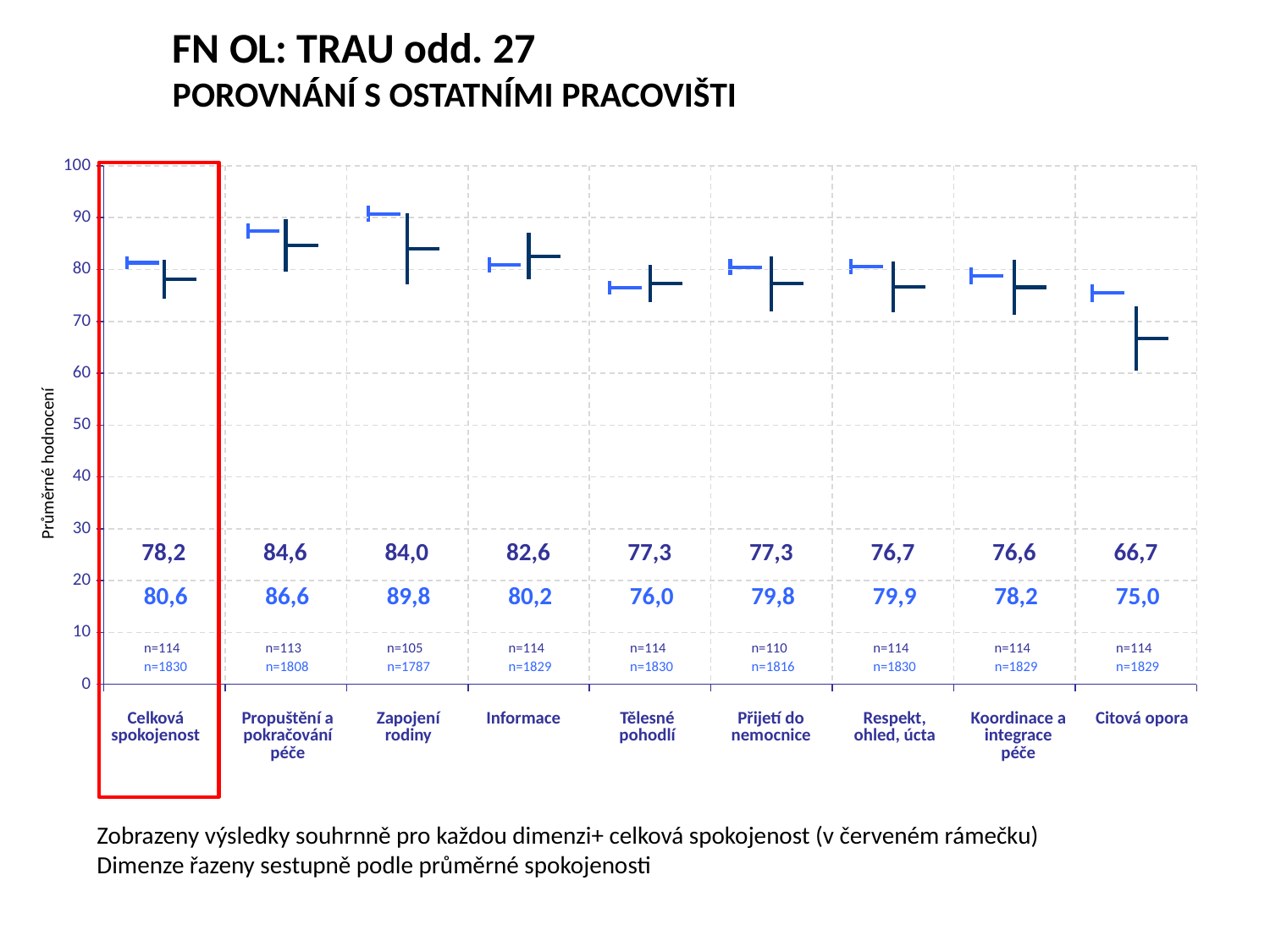
Which category has the lowest dark blue value? Citová opora What is the label of the y axis? Průměrné hodnocení What is the dark blue value printed for Celková spokojenost? 78,2 Which category has the highest light blue value? Zapojení rodiny For Zapojení rodiny, what is the difference between the light blue value and the dark blue value? 5,8 What is the light blue value printed for Informace? 80,2 What is the light blue value printed for Zapojení rodiny? 89,8 What is the dark blue value printed for Citová opora? 66,7 What is the dark blue sample size (n) printed for Zapojení rodiny? n=105 For Tělesné pohodlí, which is larger: the dark blue value or the light blue value? dark blue (77,3) How many categories are shown along the x axis of the chart? 9 For Celková spokojenost, what is the difference between the light blue value and the dark blue value? 2,4